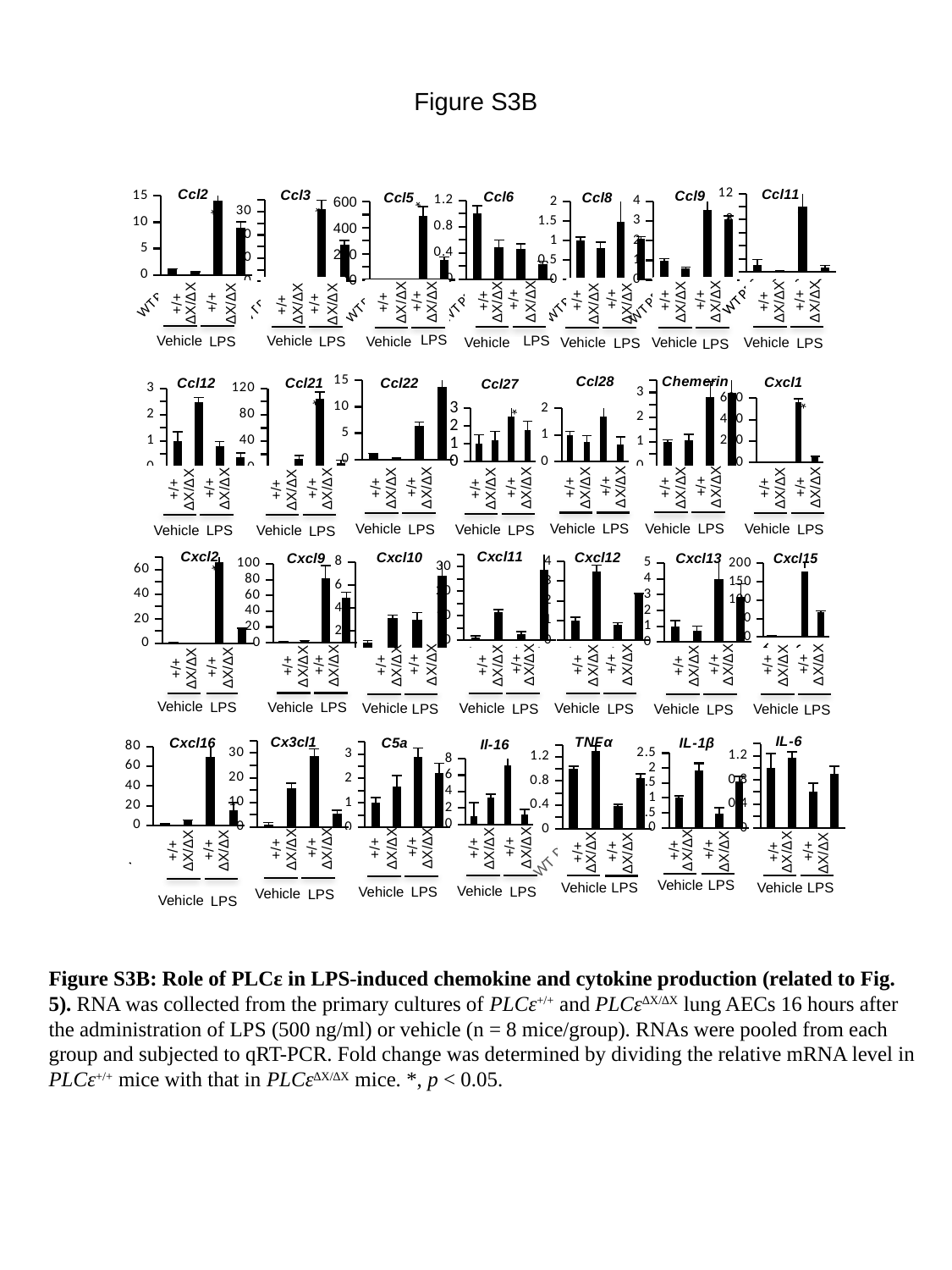
How many small bar charts are shown on the slide? 28 How many bars are plotted in the Ccl2 chart? 4 What kind of chart is the Ccl2 chart? bar chart In the Cxcl2 chart, which bar is the highest? LPS +/+ In the Ccl3 chart, which is larger, the LPS +/+ bar or the LPS ΔX/ΔX bar? LPS +/+ In the Cxcl15 chart, is the value for LPS +/+ greater or less than 150? greater In the Ccl2 chart, which bar is the highest? LPS +/+ In the Ccl2 chart, is the value for LPS +/+ greater or less than 10? greater In the Cxcl16 chart, is the value for LPS ΔX/ΔX greater or less than 40? less In the Cx3cl1 chart, which is larger, the Vehicle ΔX/ΔX bar or the LPS ΔX/ΔX bar? Vehicle ΔX/ΔX